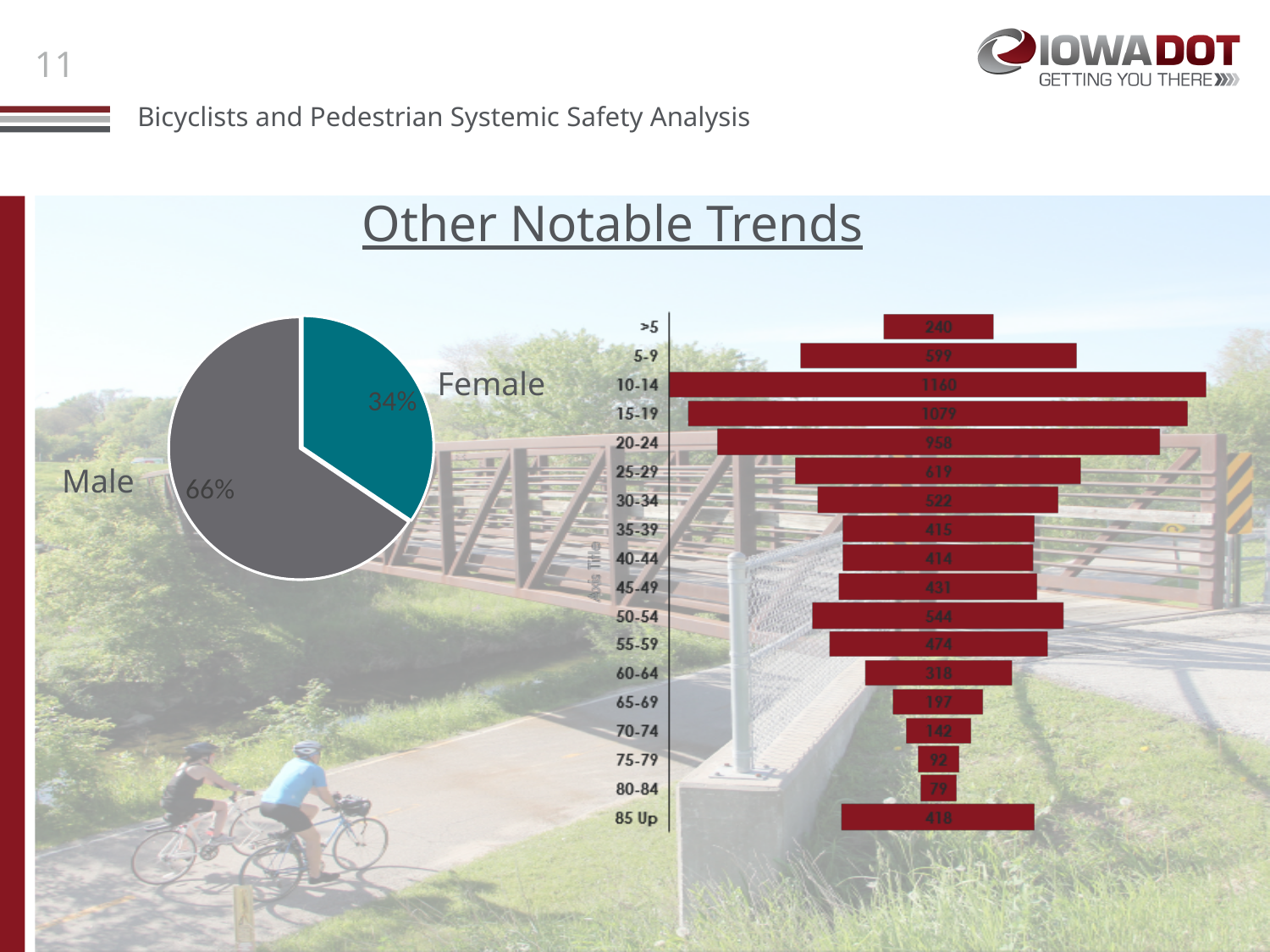
In the bar chart on the right, what is the value for the 85 Up age group? 418 What kind of chart is the age-group chart on the right? Bar chart In the pie chart on the left, what percentage is Male? 66% In the bar chart on the right, which is larger, the value for 50-54 or the value for 60-64? 50-54 In the bar chart on the right, what is the value for the 5-9 age group? 599 In the pie chart on the left, how many slices are there? 2 In the bar chart on the right, which age group has the lowest value? 80-84 In the pie chart on the left, which slice is larger, Male or Female? Male In the bar chart on the right, what is the value for the 70-74 age group? 142 In the pie chart on the left, what percentage is Female? 34% In the bar chart on the right, which age group has the highest value? 10-14 In the bar chart on the right, how many age groups are shown? 18